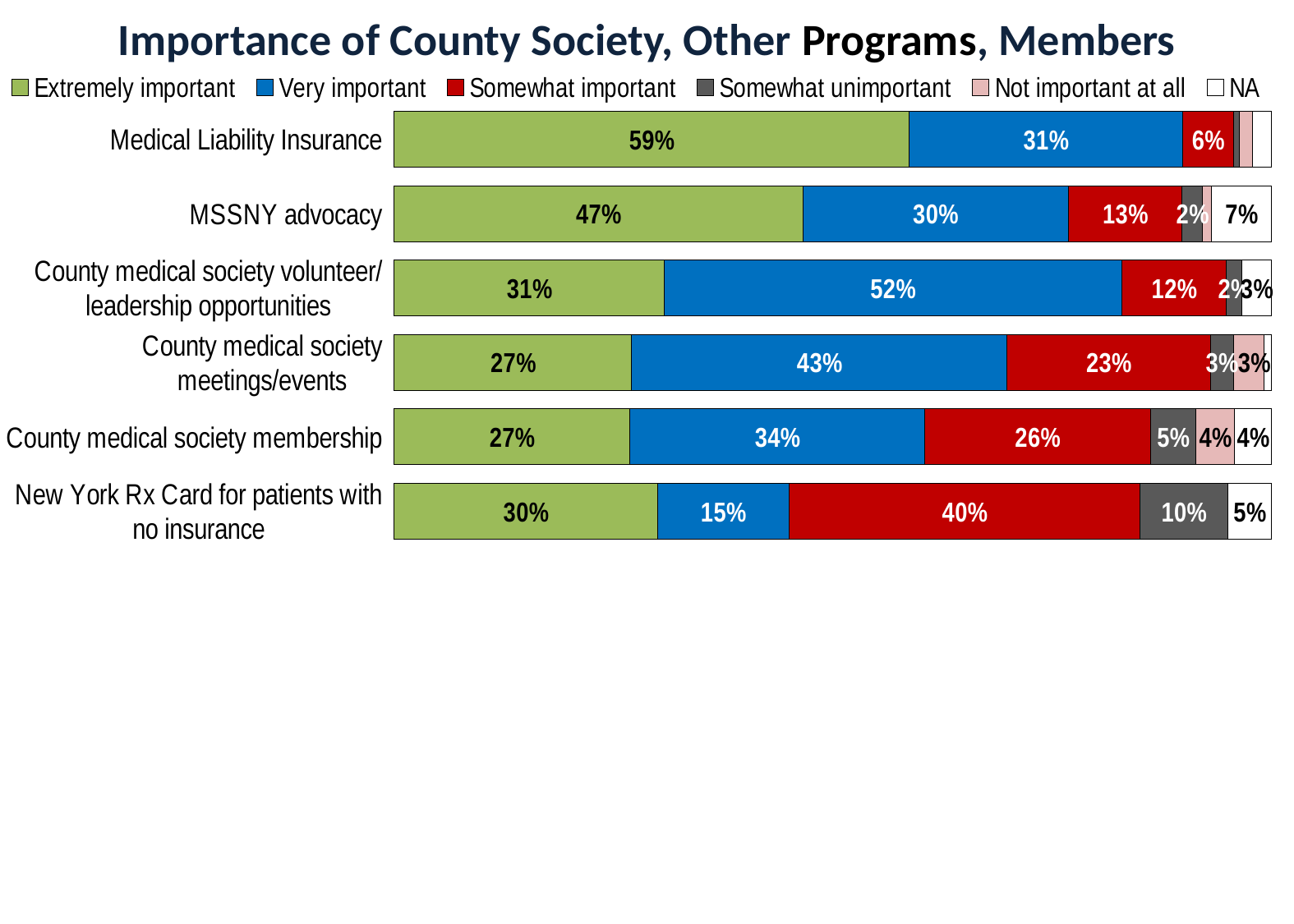
What share of members rated the New York Rx Card for patients with no insurance as Somewhat important? 40% What type of chart is shown on the slide? Stacked bar chart What percentage of members rated Medical Liability Insurance as Extremely important? 59% What is the difference between the Extremely important percentages for Medical Liability Insurance and MSSNY advocacy? 12% Which program has the highest Extremely important percentage? Medical Liability Insurance What is the NA value for MSSNY advocacy? 7% How many programs are shown in the chart? 6 What is the Very important value for County medical society volunteer/leadership opportunities? 52% Which program has the highest Somewhat important percentage? New York Rx Card for patients with no insurance Which is larger: the Somewhat important value for County medical society membership or for County medical society meetings/events? County medical society membership How many series does the legend list? 6 Which program has the lowest Very important percentage? New York Rx Card for patients with no insurance